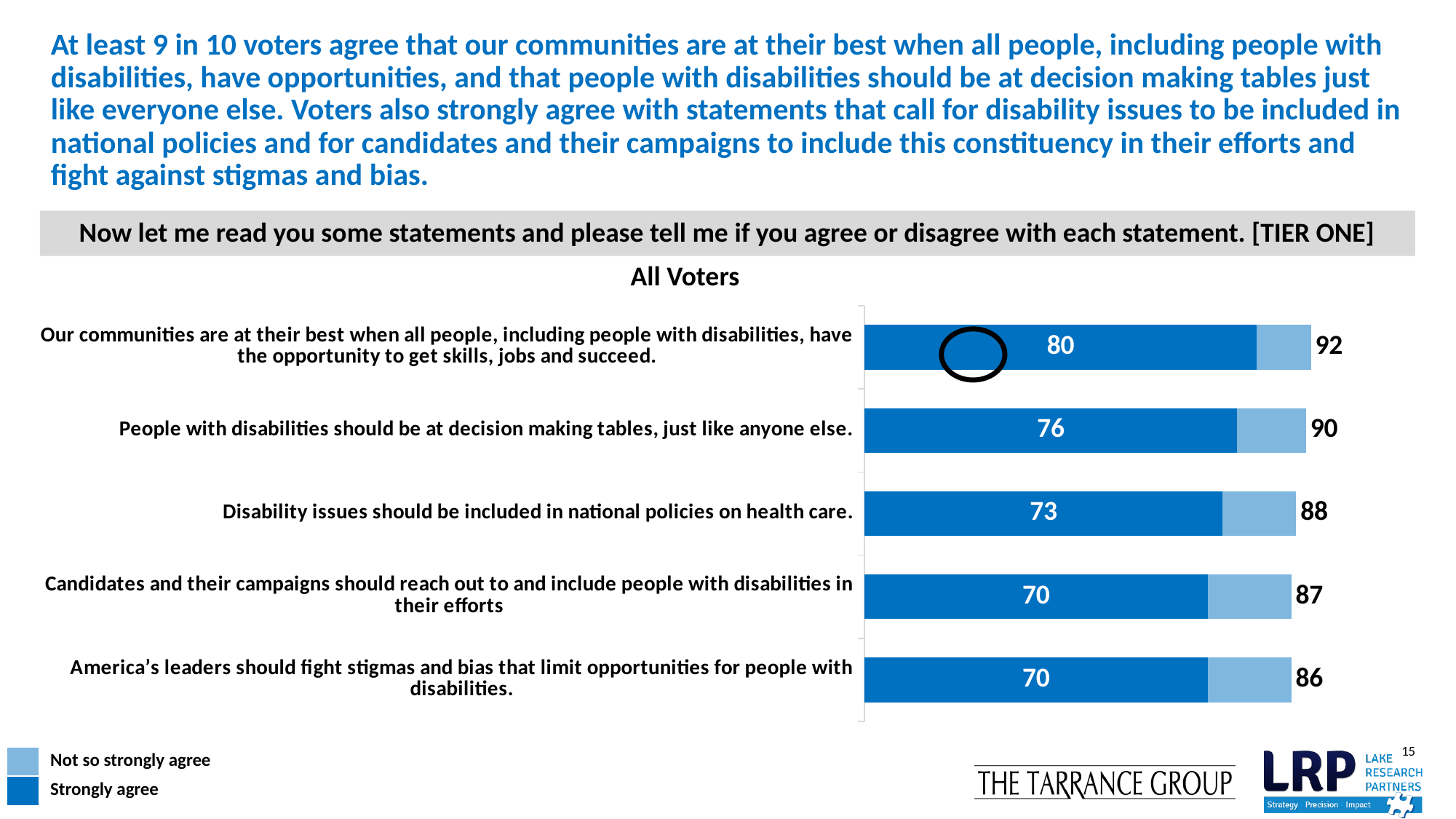
What is the total agree value for 'America's leaders should fight stigmas and bias that limit opportunities for people with disabilities'? 86 What is the total agree value for 'People with disabilities should be at decision making tables, just like anyone else'? 90 How many series does the legend list? 2 How much higher is the 'Strongly agree' value for the decision making tables statement than for the health care policies statement? 3 Which has a larger total agree value: the decision making tables statement or the health care policies statement? People with disabilities should be at decision making tables, just like anyone else. Which statement has the highest 'Strongly agree' value? Our communities are at their best when all people, including people with disabilities, have the opportunity to get skills, jobs and succeed. How many statements are shown in the chart? 5 Which statement has the lowest total agree value? America's leaders should fight stigmas and bias that limit opportunities for people with disabilities. What is the 'Strongly agree' value for 'Disability issues should be included in national policies on health care'? 73 What is the difference between the total agree value and the 'Strongly agree' value for 'Candidates and their campaigns should reach out to and include people with disabilities in their efforts'? 17 What is the 'Strongly agree' value for 'Our communities are at their best when all people, including people with disabilities, have the opportunity to get skills, jobs and succeed'? 80 What kind of chart is shown on the slide? Bar chart